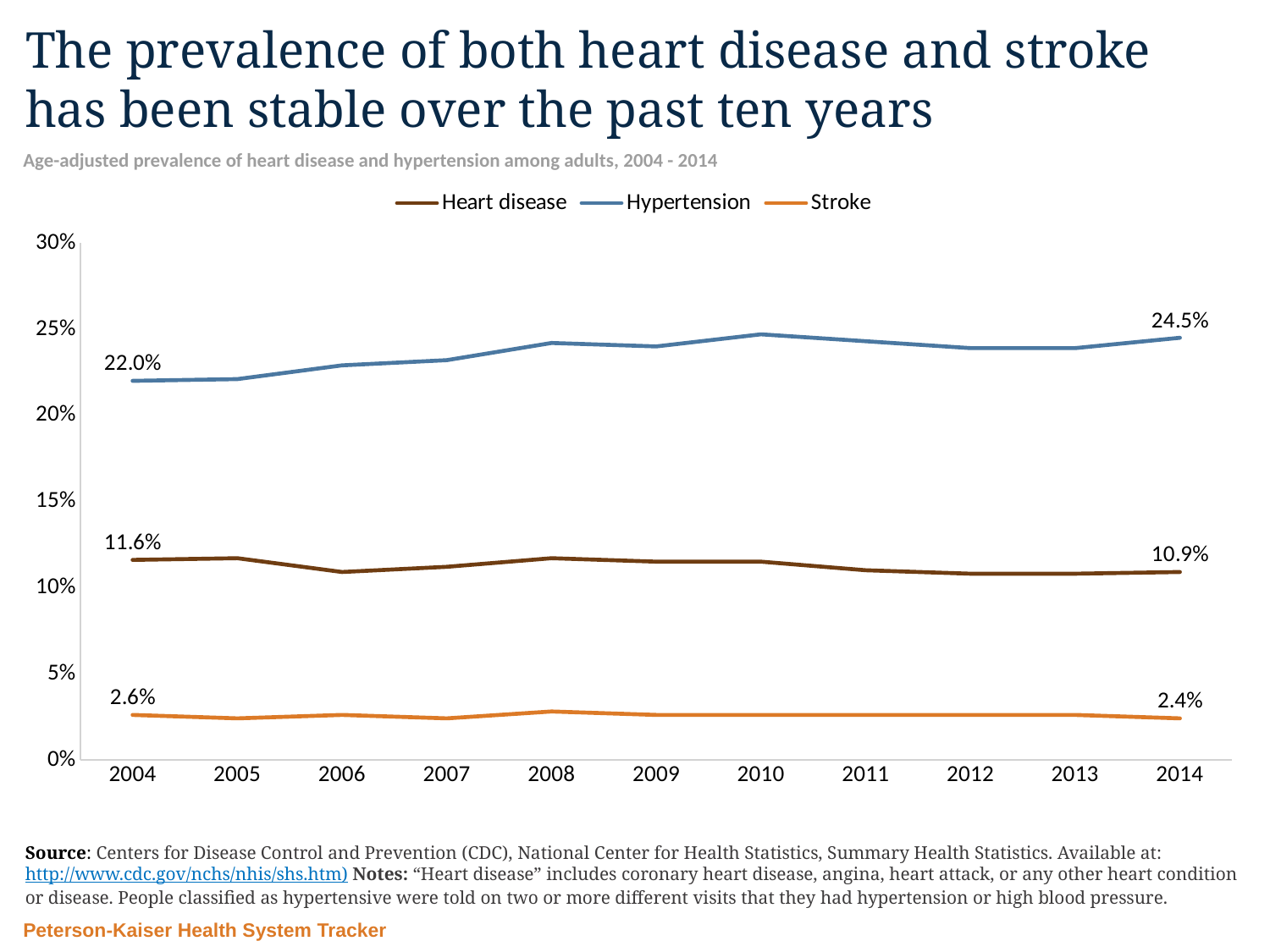
Which series has the lowest prevalence across the years shown? Stroke Which series has the highest prevalence in 2014? Hypertension What was the prevalence of hypertension in 2004? 22.0% How many years are shown on the x axis? 11 What is the difference between the heart disease prevalence in 2004 and in 2014? 0.7 percentage points What kind of chart is shown on the slide? Line chart What was the prevalence of heart disease in 2004? 11.6% By how many percentage points did the prevalence of hypertension change from 2004 to 2014? 2.5 percentage points What was the prevalence of stroke in 2014? 2.4% What was the prevalence of hypertension in 2014? 24.5% How many series does the legend list? 3 Is the prevalence of hypertension in 2010 greater or less than 20%? greater